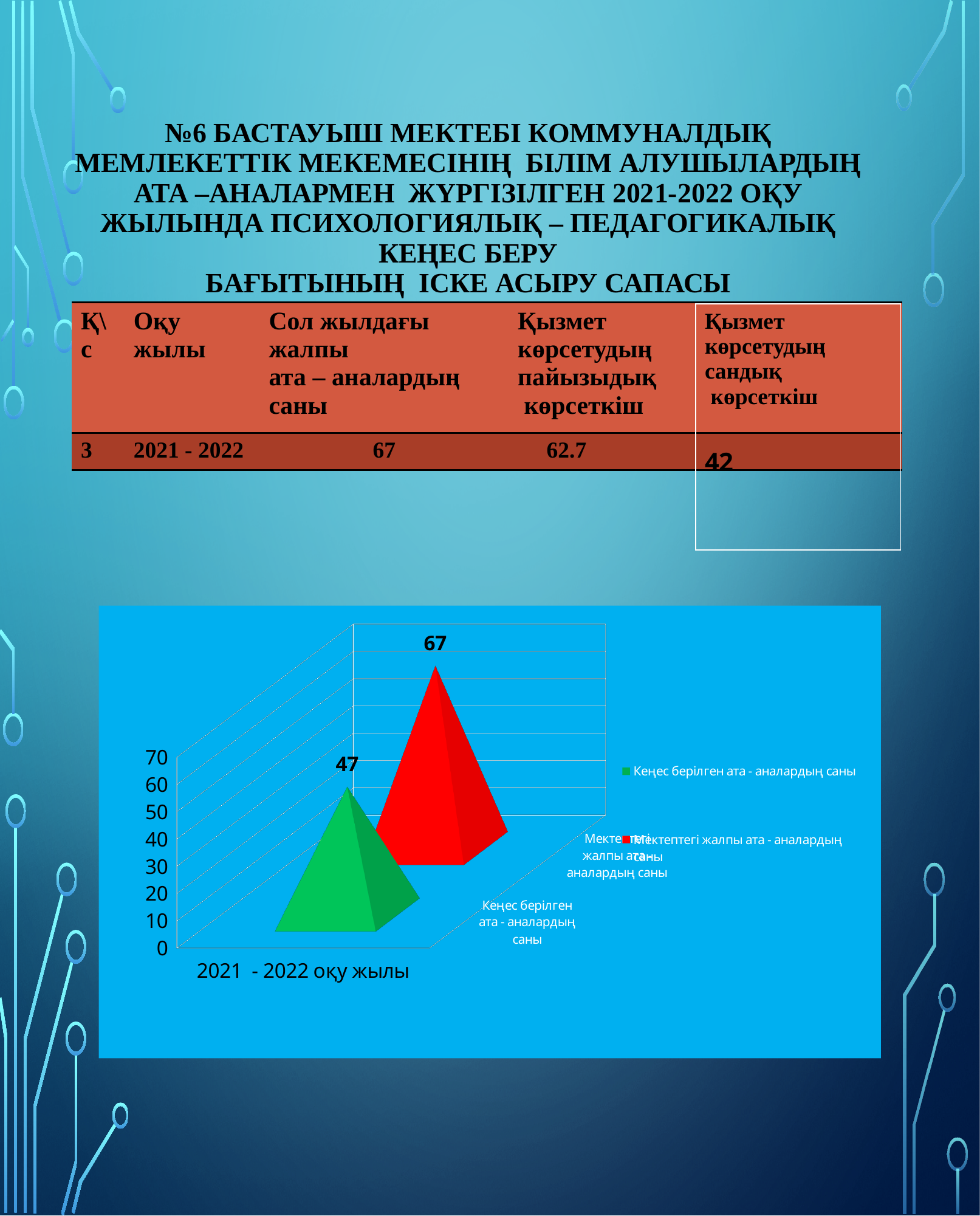
Is the value for 'Мектептегі жалпы ата - аналардың саны' greater or less than 60? greater What is the category label shown on the x axis of the chart? 2021 - 2022 оқу жылы Which series has the lower value in the chart? Кеңес берілген ата - аналардың саны What is the value of the 'Мектептегі жалпы ата - аналардың саны' series for 2021 - 2022 оқу жылы? 67 What colour represents the 'Мектептегі жалпы ата - аналардың саны' series in the chart? Red Is the value for 'Кеңес берілген ата - аналардың саны' greater or less than 50? less Is the value for 'Кеңес берілген ата - аналардың саны' larger or smaller than the value for 'Мектептегі жалпы ата - аналардың саны'? smaller Which series has the higher value in the chart? Мектептегі жалпы ата - аналардың саны What is the value of the 'Кеңес берілген ата - аналардың саны' series for 2021 - 2022 оқу жылы? 47 How many series does the chart legend list? 2 How many categories are shown on the x axis of the chart? 1 What is the difference between the 'Мектептегі жалпы ата - аналардың саны' value and the 'Кеңес берілген ата - аналардың саны' value? 20